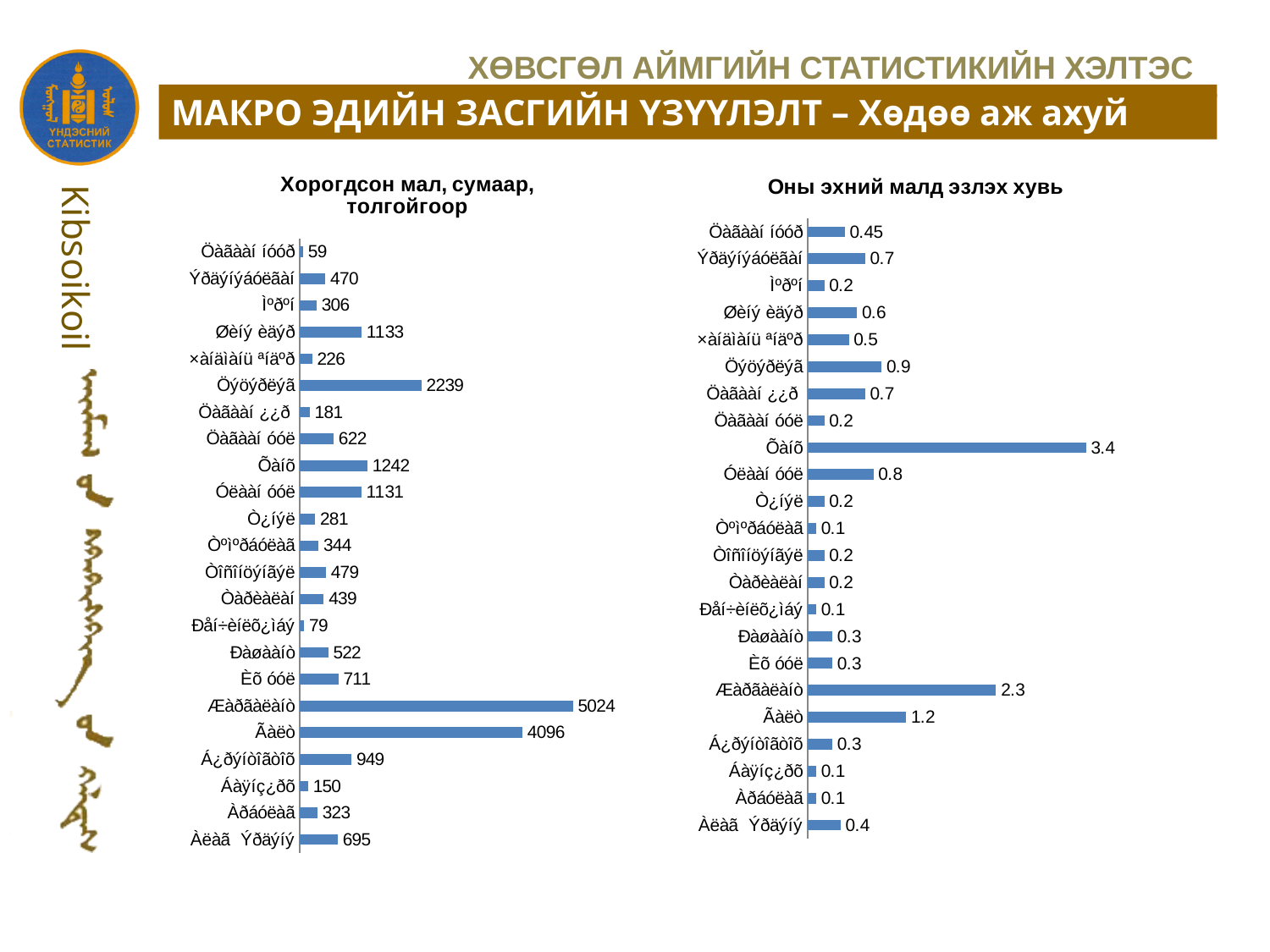
In the left chart "Хорогдсон мал, сумаар, толгойгоор", what is the highest value shown? 5024 In the left chart "Хорогдсон мал, сумаар, толгойгоор", which is larger: the top-most bar or the bottom-most bar? the bottom-most bar In the right chart "Оны эхний малд эзлэх хувь", what is the second-highest value shown? 2.3 How many categories are plotted in the right chart "Оны эхний малд эзлэх хувь"? 23 In the left chart "Хорогдсон мал, сумаар, толгойгоор", what is the difference between the two largest values, 5024 and 4096? 928 In the right chart "Оны эхний малд эзлэх хувь", what is the value of the top-most bar? 0.45 How many categories are plotted in the left chart "Хорогдсон мал, сумаар, толгойгоор"? 23 In the left chart "Хорогдсон мал, сумаар, толгойгоор", what is the lowest value shown? 59 In the left chart "Хорогдсон мал, сумаар, толгойгоор", what is the value of the bottom-most bar? 695 In the right chart "Оны эхний малд эзлэх хувь", what is the highest value shown? 3.4 What is the title of the right chart? Оны эхний малд эзлэх хувь What type of chart is the left chart titled "Хорогдсон мал, сумаар, толгойгоор"? bar chart